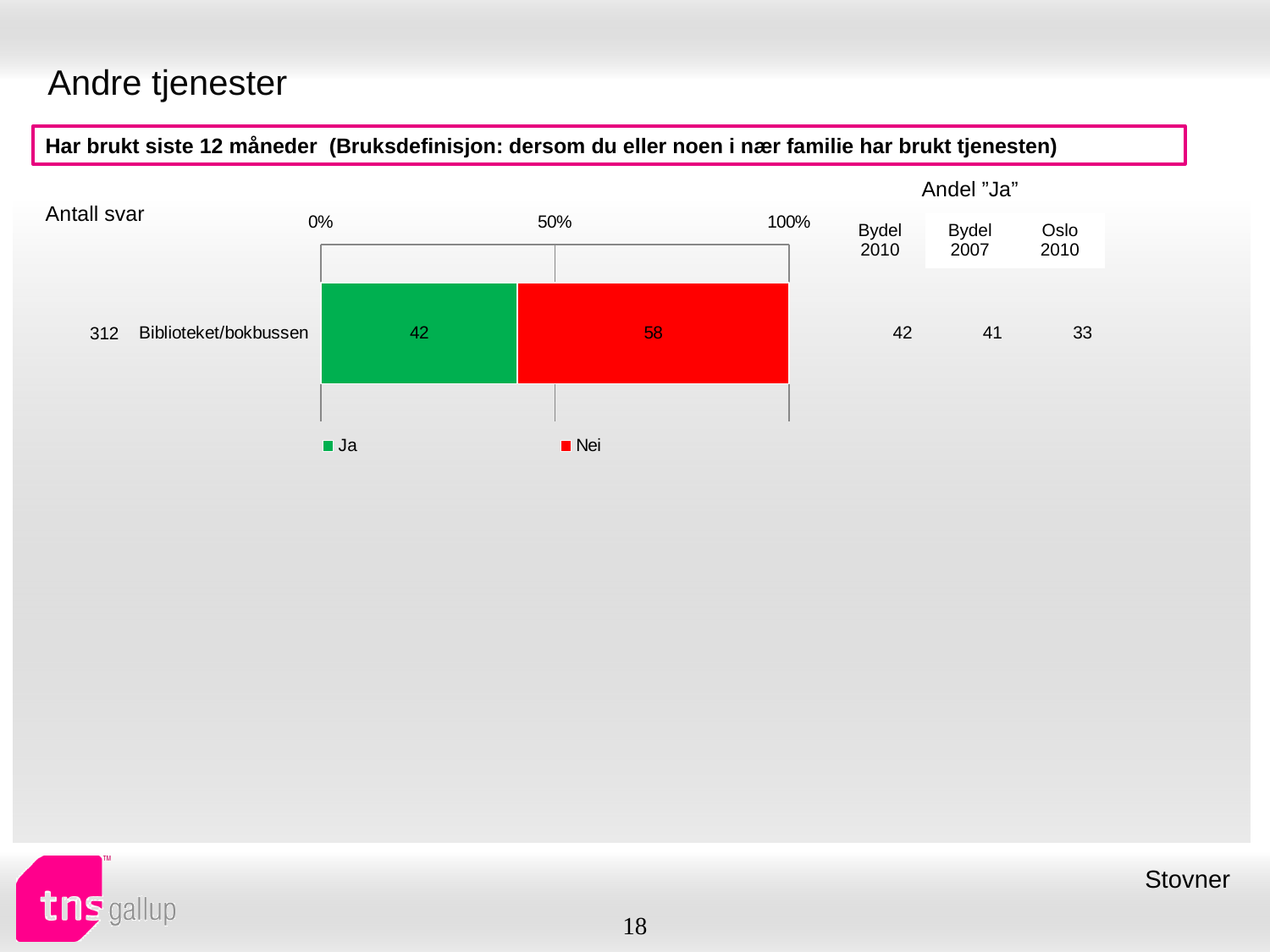
What is the value for "Ja" for Biblioteket/bokbussen? 42 Which series has the larger value for Biblioteket/bokbussen, Ja or Nei? Nei What kind of chart is shown on the slide? Stacked bar chart What is the difference between the Nei and Ja values for Biblioteket/bokbussen? 16 Is the Ja value for Biblioteket/bokbussen greater or less than 50%? less How many categories are plotted in the chart? 1 What is the number of responses (Antall svar) shown for Biblioteket/bokbussen? 312 How many series does the legend list? 2 Is the Nei value for Biblioteket/bokbussen greater or less than 50%? greater What is the total of the stacked bar for Biblioteket/bokbussen? 100 Which colour represents the "Nei" series in the chart? Red What is the value for "Nei" for Biblioteket/bokbussen? 58